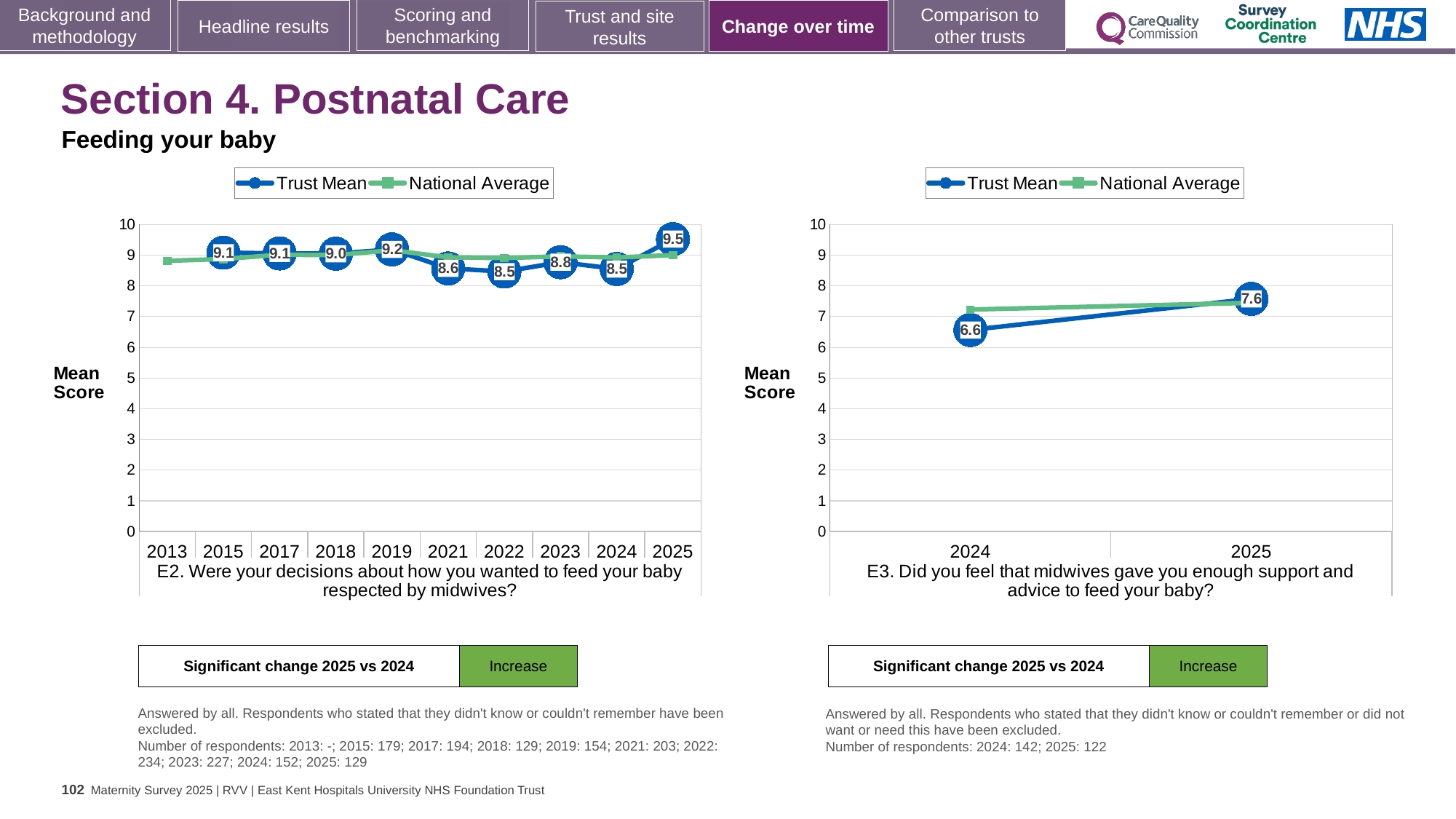
In the E3 chart on the right, which year has the lowest Trust Mean? 2024 In the E3 chart on the right, what is the Trust Mean for 2024? 6.6 How many series does the legend of the E3 chart on the right list? 2 In the E2 chart on the left, what is the Trust Mean for 2021? 8.6 In the E2 chart on the left, which year has the highest Trust Mean? 2025 In the E2 chart on the left, what is the Trust Mean for 2025? 9.5 In the E2 chart on the left, is the Trust Mean higher in 2019 or in 2022? 2019 In the E2 chart on the left, what is the difference between the Trust Mean for 2025 and 2024? 1.0 In the E3 chart on the right, what is the difference between the Trust Mean for 2025 and 2024? 1.0 What kind of chart is the E3 chart on the right? Line chart How many years are shown on the x axis of the E2 chart on the left? 10 In the E3 chart on the right, is the National Average for 2024 greater or less than 7? greater